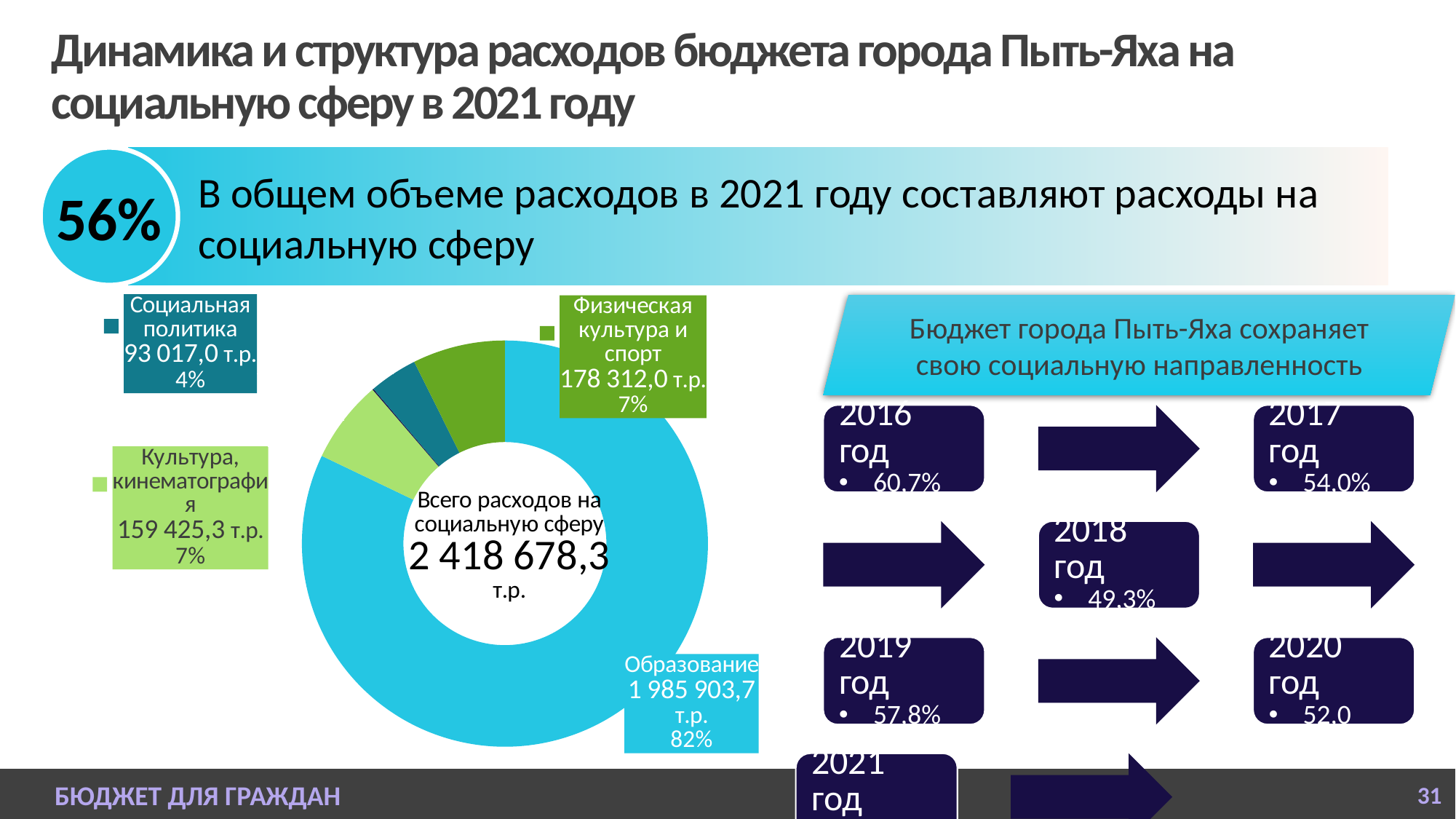
Which labelled category has the smallest share of the doughnut chart? Социальная политика What share of the doughnut chart does Социальная политика account for? 4% What is the difference between the values for Физическая культура и спорт and Культура, кинематография? 18 886,7 т.р. What kind of chart is shown on the slide? Doughnut (pie) chart Which is larger: the value for Образование or the value for Культура, кинематография? Образование What is the value for Образование in the doughnut chart? 1 985 903,7 т.р. Which category has the largest share of the doughnut chart? Образование What share of the doughnut chart does Образование account for? 82% What is the total of all expenditures on the social sphere shown in the centre of the doughnut chart? 2 418 678,3 т.р. What is the value for Социальная политика in the doughnut chart? 93 017,0 т.р. What is the value for Физическая культура и спорт in the doughnut chart? 178 312,0 т.р. What is the value for Культура, кинематография in the doughnut chart? 159 425,3 т.р.